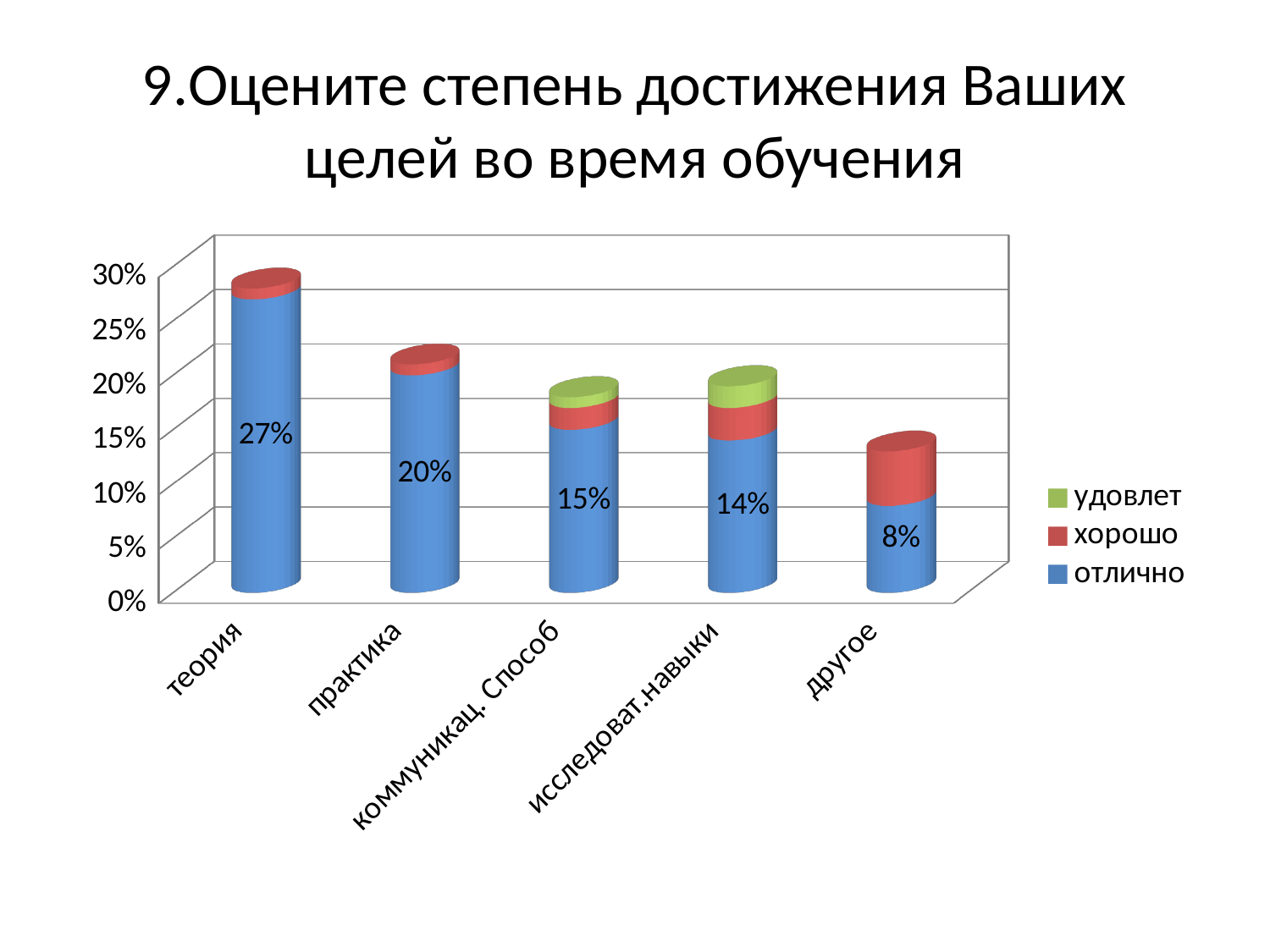
What is the value of the отлично series for коммуникац. Способ? 15% Which has a larger отлично value, практика or исследоват.навыки? практика Do the отлично values rise or fall from left to right along the x axis? fall What is the value of the отлично series for теория? 27% How many categories are shown on the x axis? 5 Which category has the lowest отлично value? другое Is the total height of the теория bar greater or less than 25%? greater Which category has the highest отлично value? теория How many series does the legend list? 3 What is the value of the отлично series for практика? 20% What is the difference between the отлично values for теория and другое? 19% What is the value of the отлично series for другое? 8%